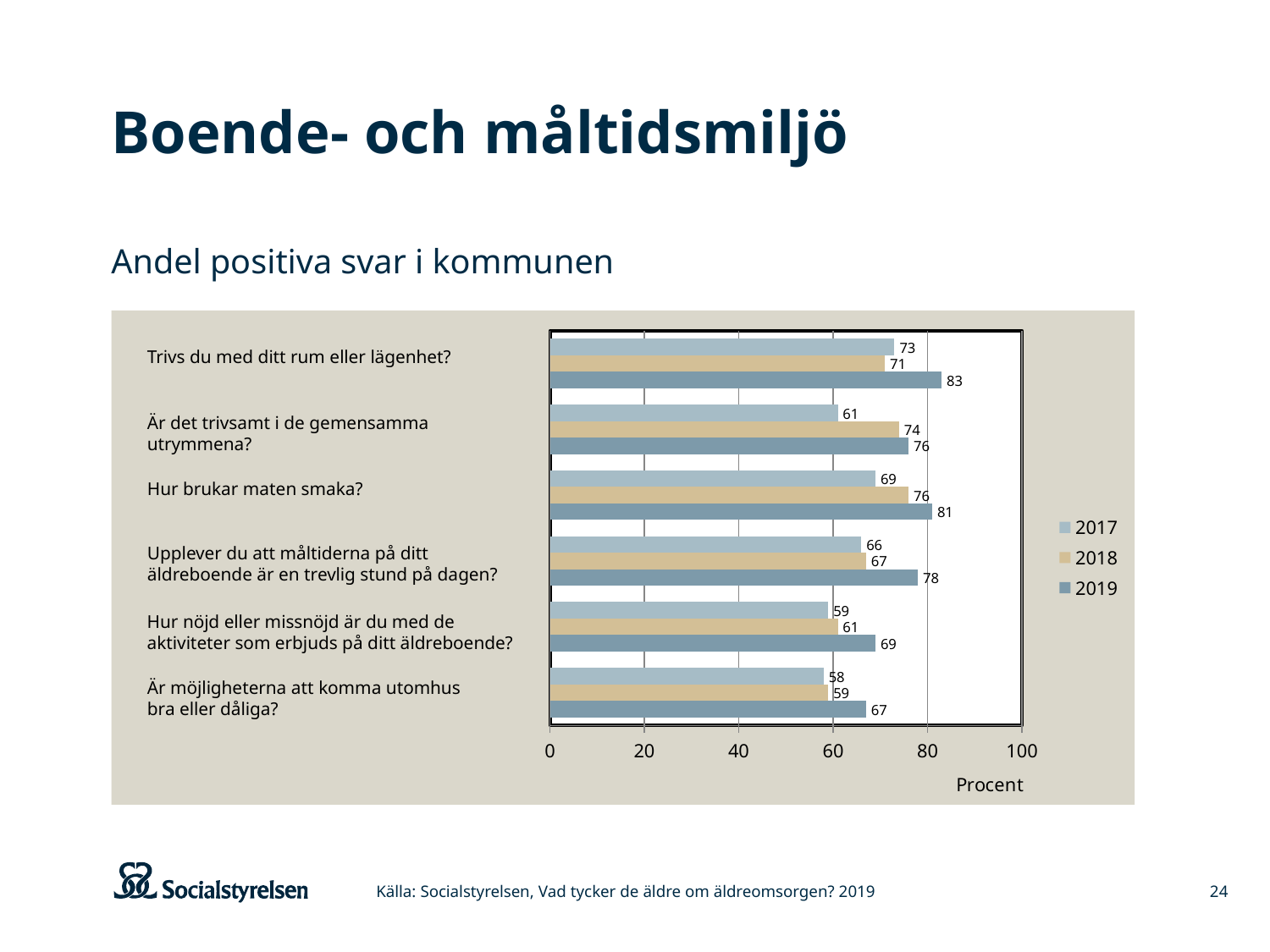
How many series does the legend list? 3 What is the 2017 value for "Är det trivsamt i de gemensamma utrymmena?"? 61 What is the 2019 value for "Hur nöjd eller missnöjd är du med de aktiviteter som erbjuds på ditt äldreboende?"? 69 What is the 2019 value for "Trivs du med ditt rum eller lägenhet?"? 83 What is the 2018 value for "Hur brukar maten smaka?"? 76 What kind of chart is shown on the slide? Bar chart What is the label on the horizontal axis of the chart? Procent What is the difference between the 2019 and 2017 values for "Är det trivsamt i de gemensamma utrymmena?"? 15 Which question has the highest 2019 value? Trivs du med ditt rum eller lägenhet? How many questions (categories) are shown in the chart? 6 Which question has the lowest 2017 value? Är möjligheterna att komma utomhus bra eller dåliga? For "Upplever du att måltiderna på ditt äldreboende är en trevlig stund på dagen?", which year has the larger value, 2018 or 2019? 2019